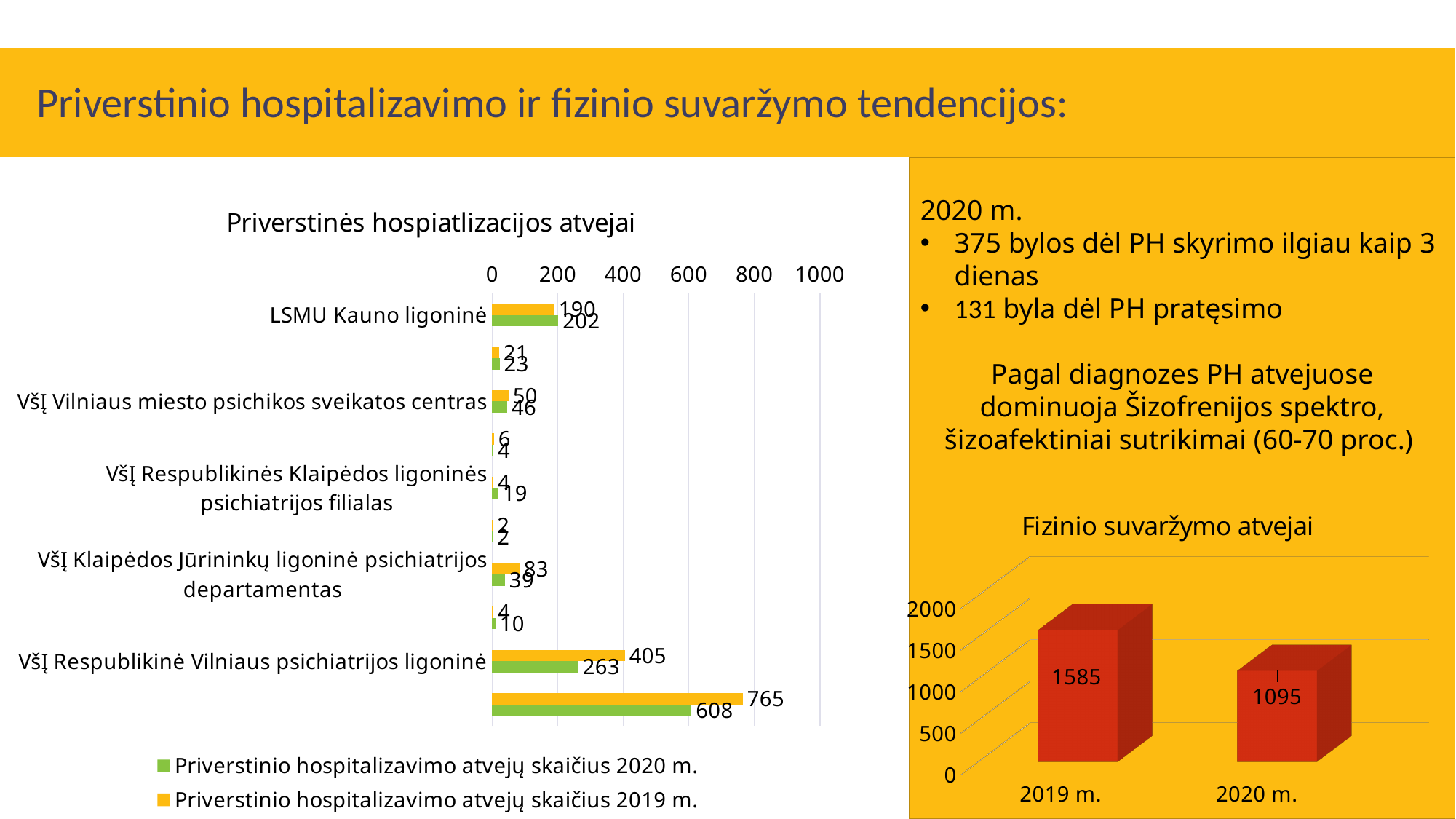
In the 'Priverstinės hospiatlizacijos atvejai' chart, which colour represents the 2019 m. series? orange In the 'Fizinio suvaržymo atvejai' chart, what is the value for 2019 m.? 1585 In the 'Fizinio suvaržymo atvejai' chart, what is the difference between the 2019 m. and 2020 m. values? 490 In the 'Priverstinės hospiatlizacijos atvejai' chart, which is larger for VšĮ Respublikinė Vilniaus psichiatrijos ligoninė: the 2019 m. value or the 2020 m. value? 2019 m. In the 'Fizinio suvaržymo atvejai' chart, how many bars are plotted? 2 In the 'Priverstinės hospiatlizacijos atvejai' chart, how many series does the legend list? 2 In the 'Fizinio suvaržymo atvejai' chart, what is the value for 2020 m.? 1095 What kind of chart is 'Priverstinės hospiatlizacijos atvejai'? bar chart In the 'Fizinio suvaržymo atvejai' chart, do the values rise or fall from 2019 m. to 2020 m.? fall In the 'Priverstinės hospiatlizacijos atvejai' chart, what is the 2020 m. value for LSMU Kauno ligoninė? 202 In the 'Priverstinės hospiatlizacijos atvejai' chart, what is the 2019 m. value for VšĮ Respublikinė Vilniaus psichiatrijos ligoninė? 405 In the 'Fizinio suvaržymo atvejai' chart, which year has the higher value? 2019 m.